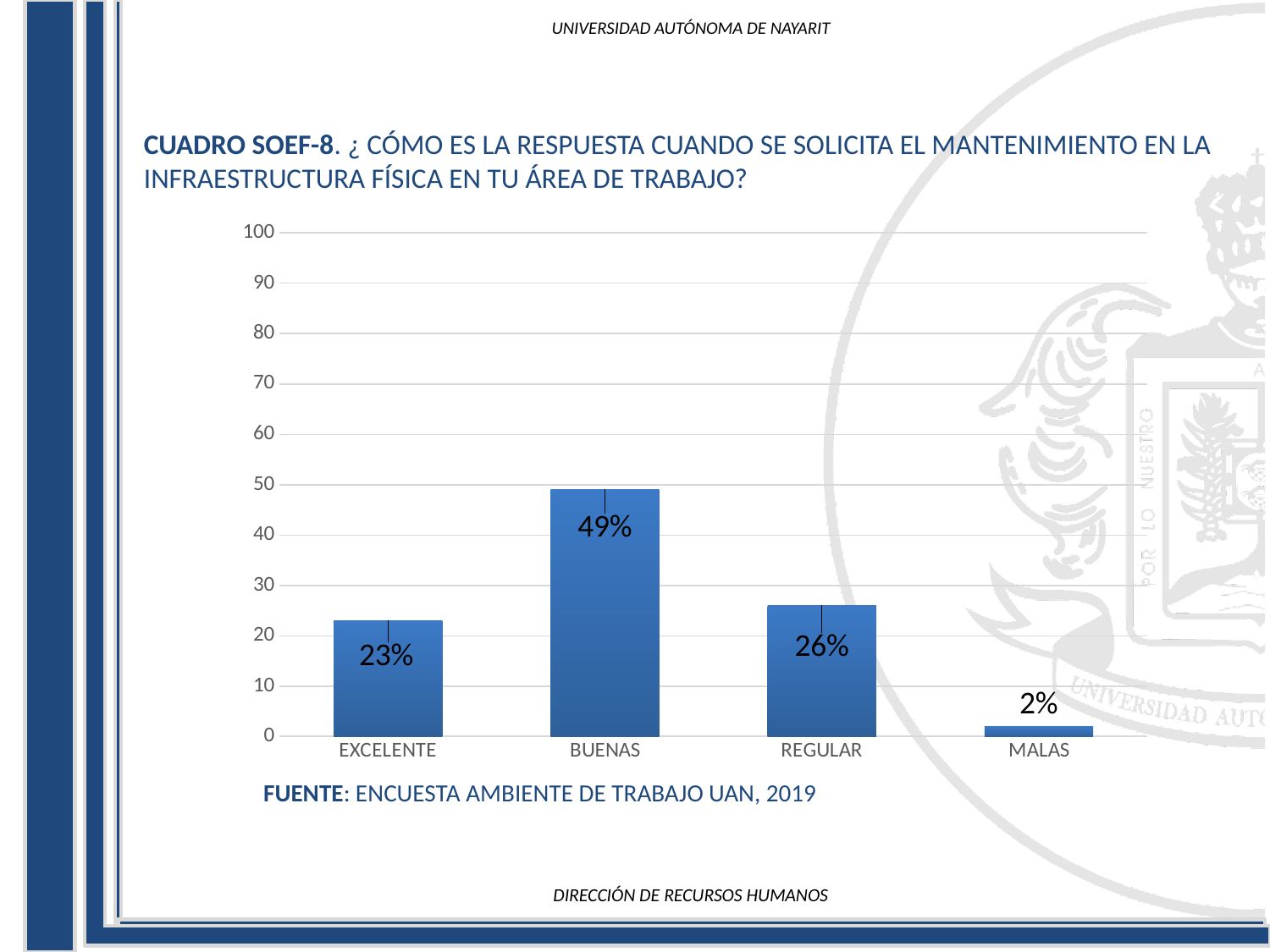
What is the value for MALAS? 2% Which category has the highest value? BUENAS What source is cited below the chart? ENCUESTA AMBIENTE DE TRABAJO UAN, 2019 Which is larger, the value for REGULAR or the value for EXCELENTE? REGULAR What is the difference between the values for BUENAS and REGULAR? 23% What is the value for REGULAR? 26% How many categories are shown on the x axis? 4 Which category has the lowest value? MALAS What kind of chart is shown on the slide? bar chart What is the value for BUENAS? 49% What is the value for EXCELENTE? 23% Is the value for BUENAS greater or less than 40? greater